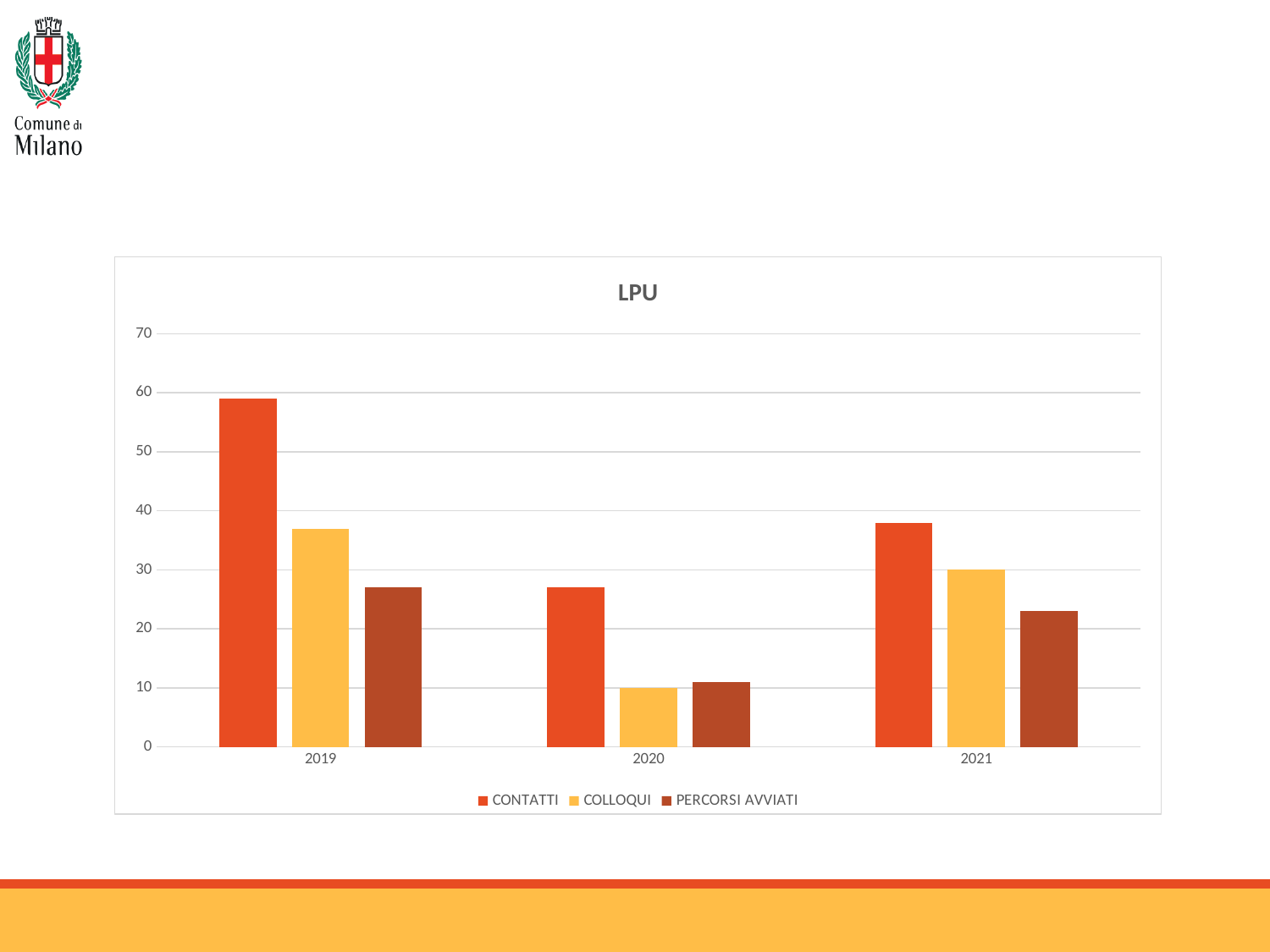
What kind of chart is shown on the slide? bar chart Which year has the lowest COLLOQUI value? 2020 Which series is shown in yellow in the legend? COLLOQUI Is the COLLOQUI value for 2021 greater or less than 20? greater How many series does the legend list? 3 What is the title of the chart? LPU Which year has the highest CONTATTI value? 2019 Which is larger, the CONTATTI value for 2020 or the CONTATTI value for 2021? 2021 Is the PERCORSI AVVIATI value for 2020 greater or less than 20? less Which is larger in 2019, COLLOQUI or PERCORSI AVVIATI? COLLOQUI How many years are shown on the x axis? 3 Is the CONTATTI value for 2019 greater or less than 50? greater